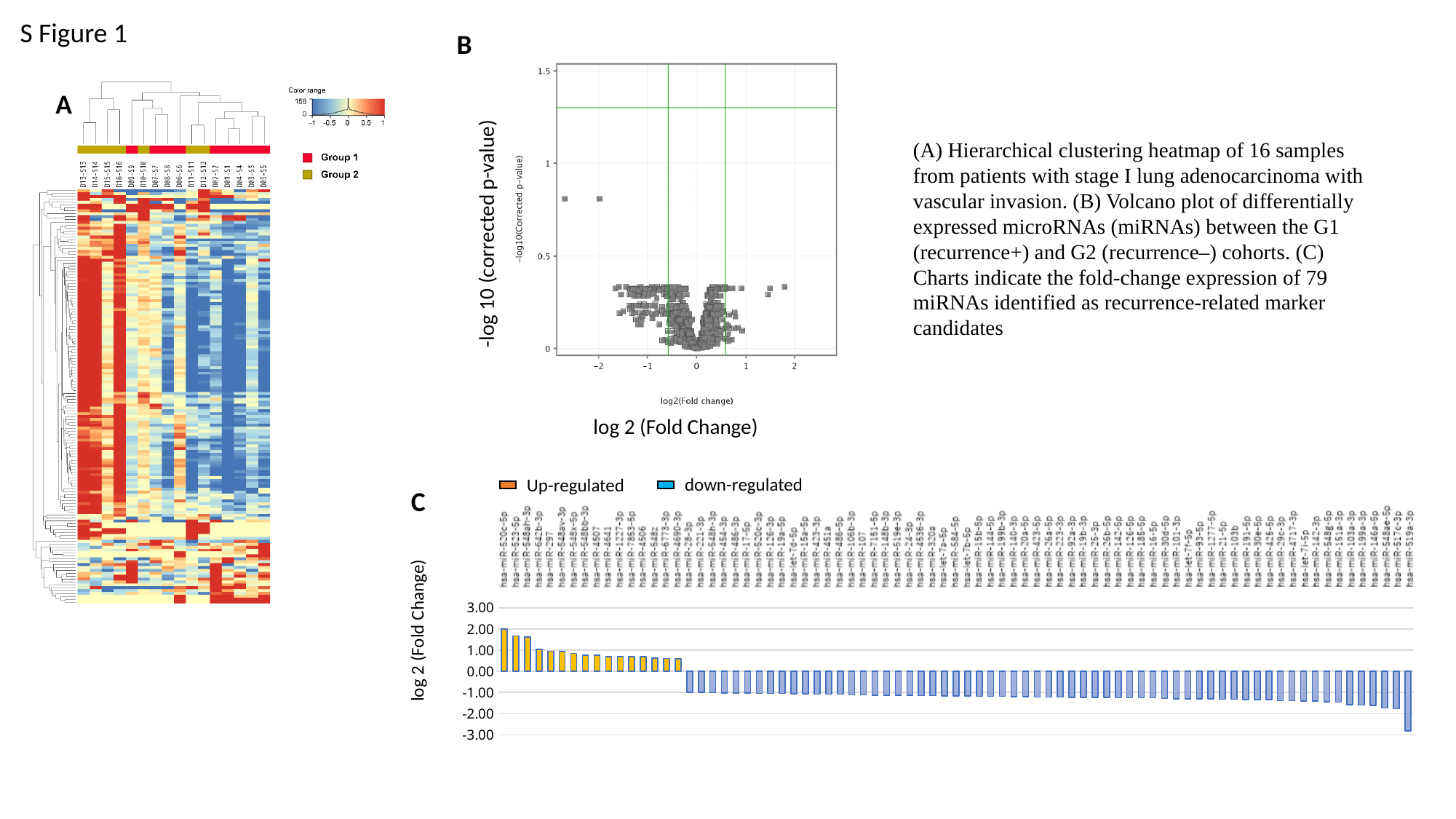
In panel C, is the value for hsa-miR-519a-3p greater or less than -2.00? less In panel C, how many series does the legend list? 2 In panel C, which has the larger log 2 (Fold Change): hsa-miR-520c-5p or hsa-miR-523-5p? hsa-miR-520c-5p In panel C, is the value for hsa-miR-28-3p greater or less than 0.00? less In panel C, which miRNA has the highest log 2 (Fold Change)? hsa-miR-520c-5p What kind of chart is panel C? bar chart In panel C, which miRNA has the lowest log 2 (Fold Change)? hsa-miR-519a-3p In panel C, what are the two legend entries? Up-regulated and down-regulated What is the x-axis label of the volcano plot in panel B? log 2 (Fold Change) In panel C, do the bar values rise or fall from left to right along the x axis? fall In panel C, is the value for hsa-miR-520c-5p greater or less than 1.00? greater According to the slide, how many miRNAs are shown in the panel C charts? 79